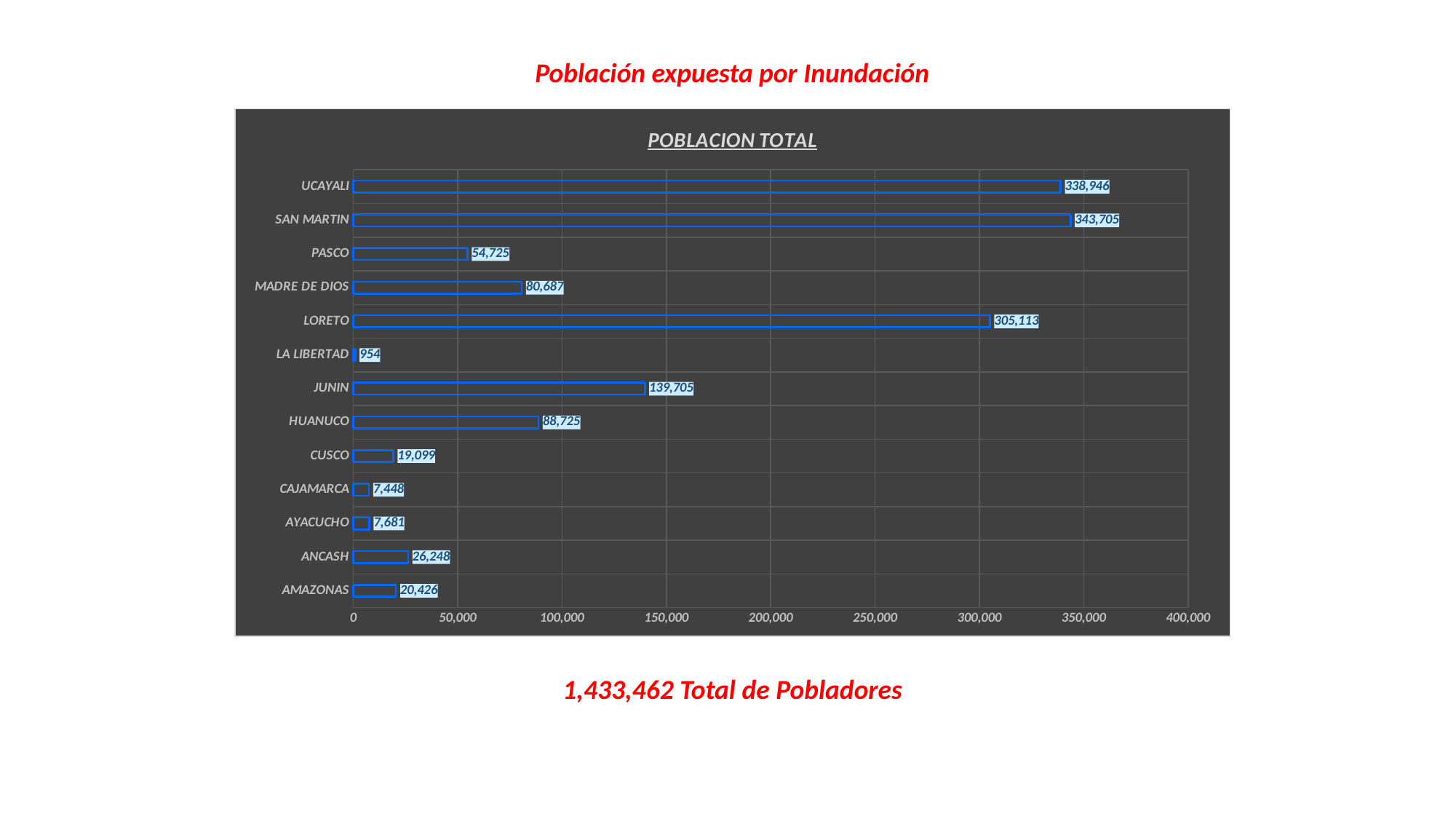
What is the difference between the values for JUNIN and HUANUCO? 50,980 What is the value for JUNIN? 139,705 What is the value for LORETO? 305,113 Is the value for HUANUCO greater or less than 100,000? less What is the value for LA LIBERTAD? 954 What kind of chart is shown on the slide? bar chart Which category has the highest value? SAN MARTIN What is the title of the chart? POBLACION TOTAL Which category has the lowest value? LA LIBERTAD How many categories are shown in the chart? 13 What is the difference between the values for SAN MARTIN and UCAYALI? 4,759 Which is larger, the value for MADRE DE DIOS or the value for PASCO? MADRE DE DIOS